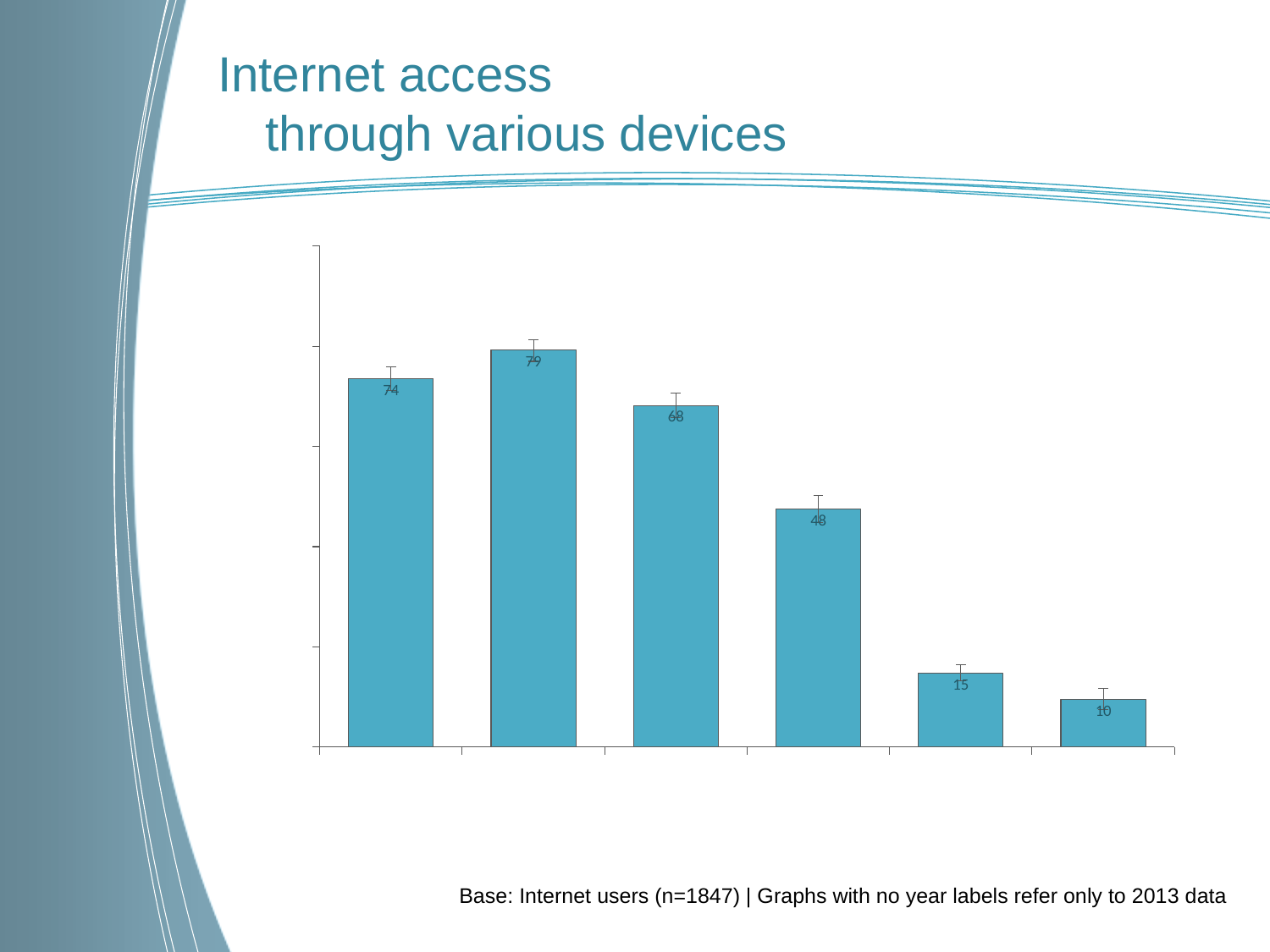
Which bar has the lowest value? the rightmost bar (10) What is the title of the slide containing the chart? Internet access through various devices What is the value of the third bar from the left? 68 What is the value of the first (leftmost) bar? 74 What type of chart is shown on the slide? bar chart How many bars are plotted in the chart? 6 What is the value of the fourth bar from the left? 48 What is the difference between the second bar (79) and the first bar (74)? 5 What is the value of the second bar from the left? 79 Which bar has the highest value? the second bar from the left (79) What is the value of the last (rightmost) bar? 10 Which is larger, the value of the fourth bar or the value of the fifth bar? the fourth bar (48)